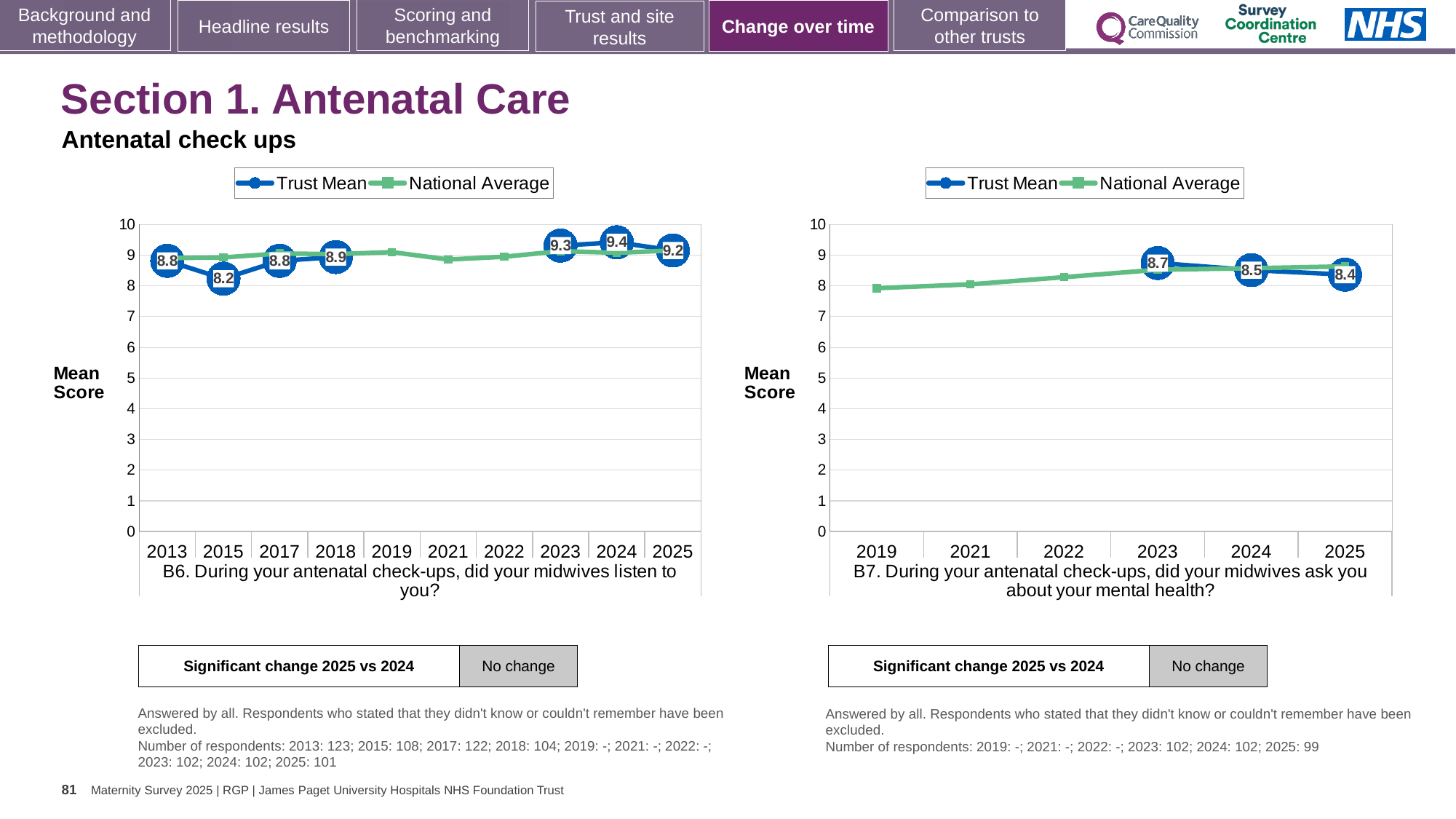
In the B7 chart (right), how many years are shown on the x axis? 6 In the B7 chart (right), which year has the lowest Trust Mean? 2025 In the B7 chart (right), is the Trust Mean for 2024 larger or smaller than the Trust Mean for 2023? smaller In the B6 chart (left), what is the Trust Mean for 2025? 9.2 What kind of chart is the B7 chart (right)? line chart In the B6 chart (left), which year has the lowest Trust Mean? 2015 In the B6 chart (left), which year has the highest Trust Mean? 2024 In the B7 chart (right), is the National Average for 2019 greater or less than 9? less In the B7 chart (right), what is the Trust Mean for 2023? 8.7 In the B6 chart (left), how many series does the legend list? 2 In the B6 chart (left), what is the difference between the Trust Mean for 2024 and 2025? 0.2 In the B6 chart (left), what is the Trust Mean for 2015? 8.2